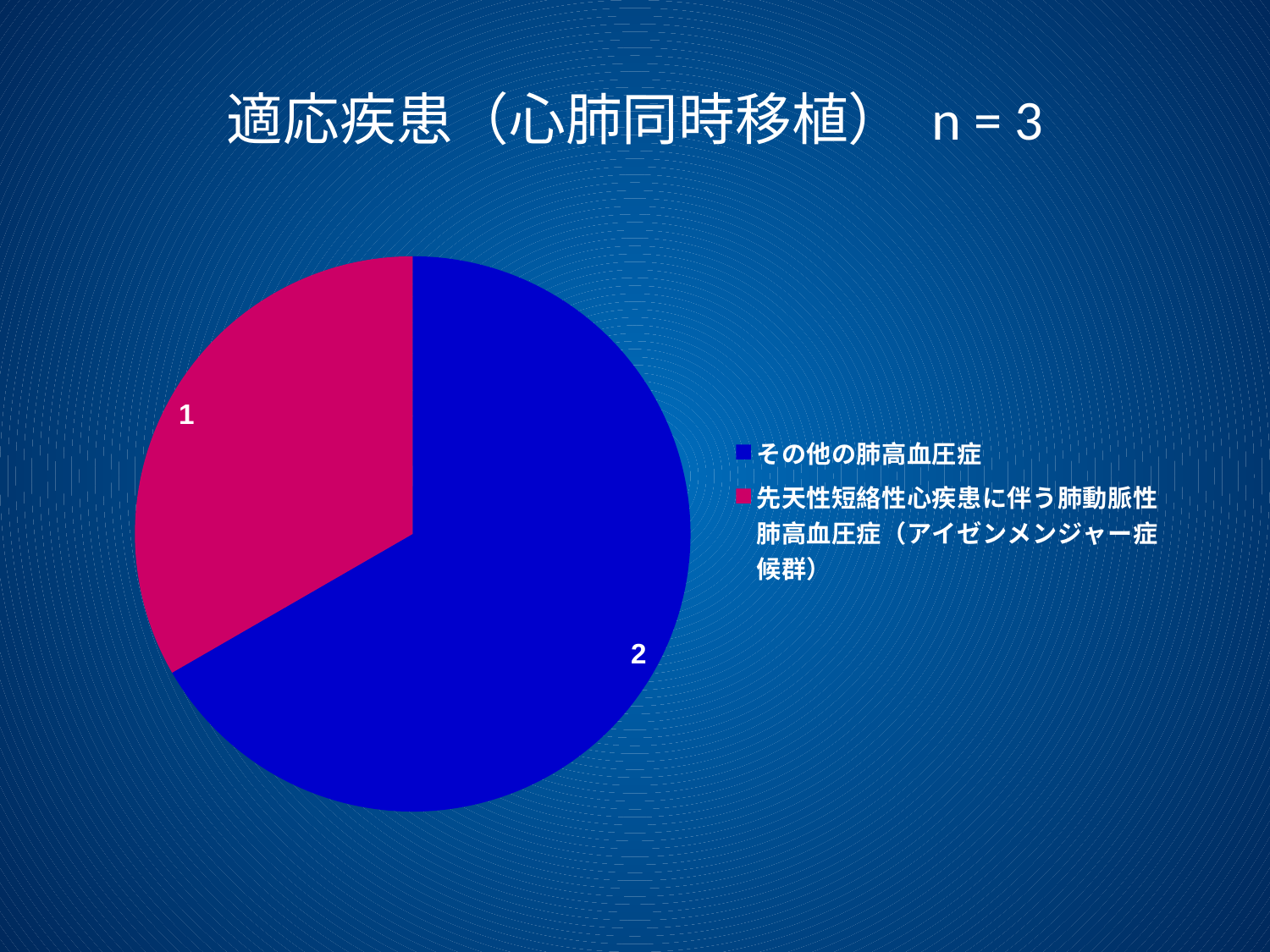
What is the value for その他の肺高血圧症? 2 What colour is the slice for その他の肺高血圧症? blue Which is larger: the value for その他の肺高血圧症 or the value for 先天性短絡性心疾患に伴う肺動脈性肺高血圧症（アイゼンメンジャー症候群）? その他の肺高血圧症 What is the title of the chart? 適応疾患（心肺同時移植） n = 3 What is the value for 先天性短絡性心疾患に伴う肺動脈性肺高血圧症（アイゼンメンジャー症候群）? 1 What is the difference between the value for その他の肺高血圧症 and the value for 先天性短絡性心疾患に伴う肺動脈性肺高血圧症（アイゼンメンジャー症候群）? 1 Which category has the largest slice? その他の肺高血圧症 How many slices does the pie chart have? 2 What is the total of all slices in the pie chart? 3 What kind of chart is shown on the slide? pie chart Which category has the smallest slice? 先天性短絡性心疾患に伴う肺動脈性肺高血圧症（アイゼンメンジャー症候群） What share of the pie does その他の肺高血圧症 represent? 2/3